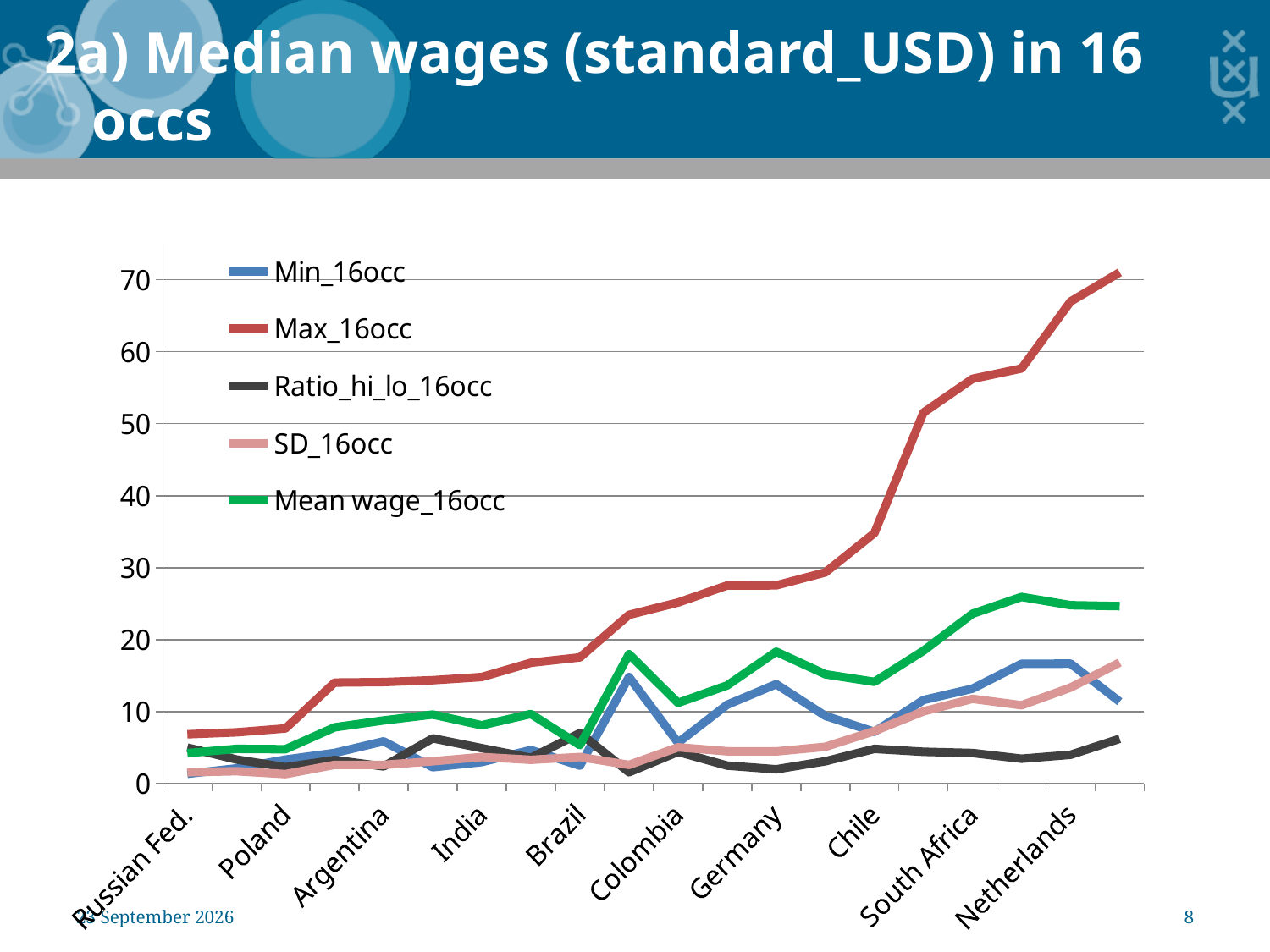
Which series reaches the highest value on the chart? Max_16occ What is the title of the slide's chart? 2a) Median wages (standard_USD) in 16 occs Does the Max_16occ series generally rise or fall from left to right along the x axis? rise What kind of chart is shown on the slide? line chart At Netherlands, which is larger: Max_16occ or Mean wage_16occ? Max_16occ Is the value of Max_16occ at Netherlands greater or less than 50? greater Is the value of Ratio_hi_lo_16occ at Netherlands greater or less than 10? less Which series has the lowest value at Netherlands? Ratio_hi_lo_16occ Is the value of Max_16occ at Russian Fed. greater or less than 10? less What colour is the Max_16occ line? red How many series does the legend list? 5